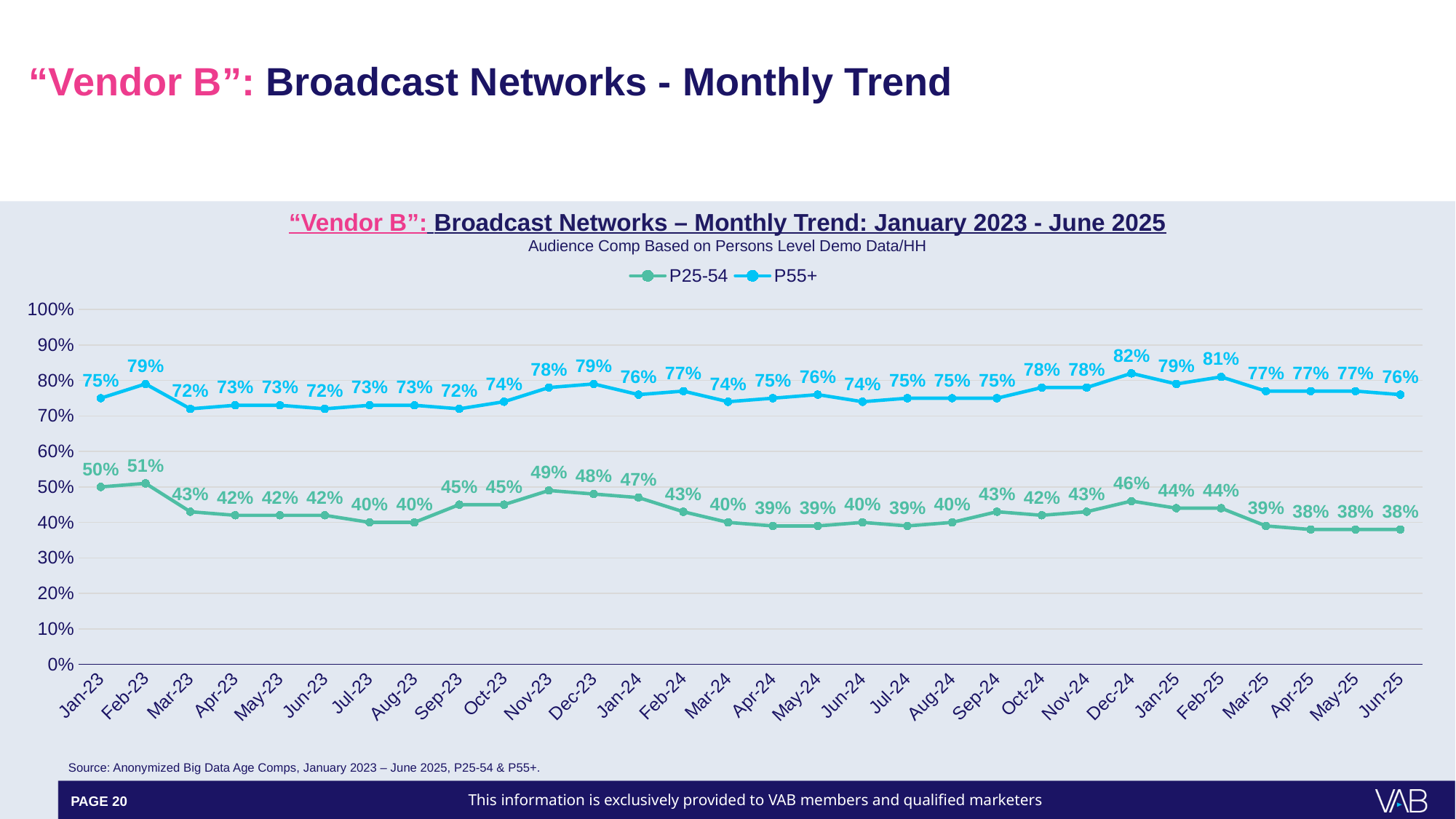
In which month does the P25-54 series reach its highest value? Feb-23 What is the P25-54 value for Jun-25? 38% What is the P55+ value for Jan-23? 75% What is the P25-54 value for Nov-23? 49% How many series does the legend list? 2 In which month does the P55+ series reach its highest value? Dec-24 How many months are plotted on the x axis? 30 What kind of chart is shown on the slide? Line chart Which is larger, the P55+ value for Feb-25 or for Mar-25? Feb-25 What is the P55+ value for Dec-24? 82% What is the difference between the P25-54 values for Feb-23 and Mar-23? 8% What is the difference between the P55+ and P25-54 values in Jun-25? 38%